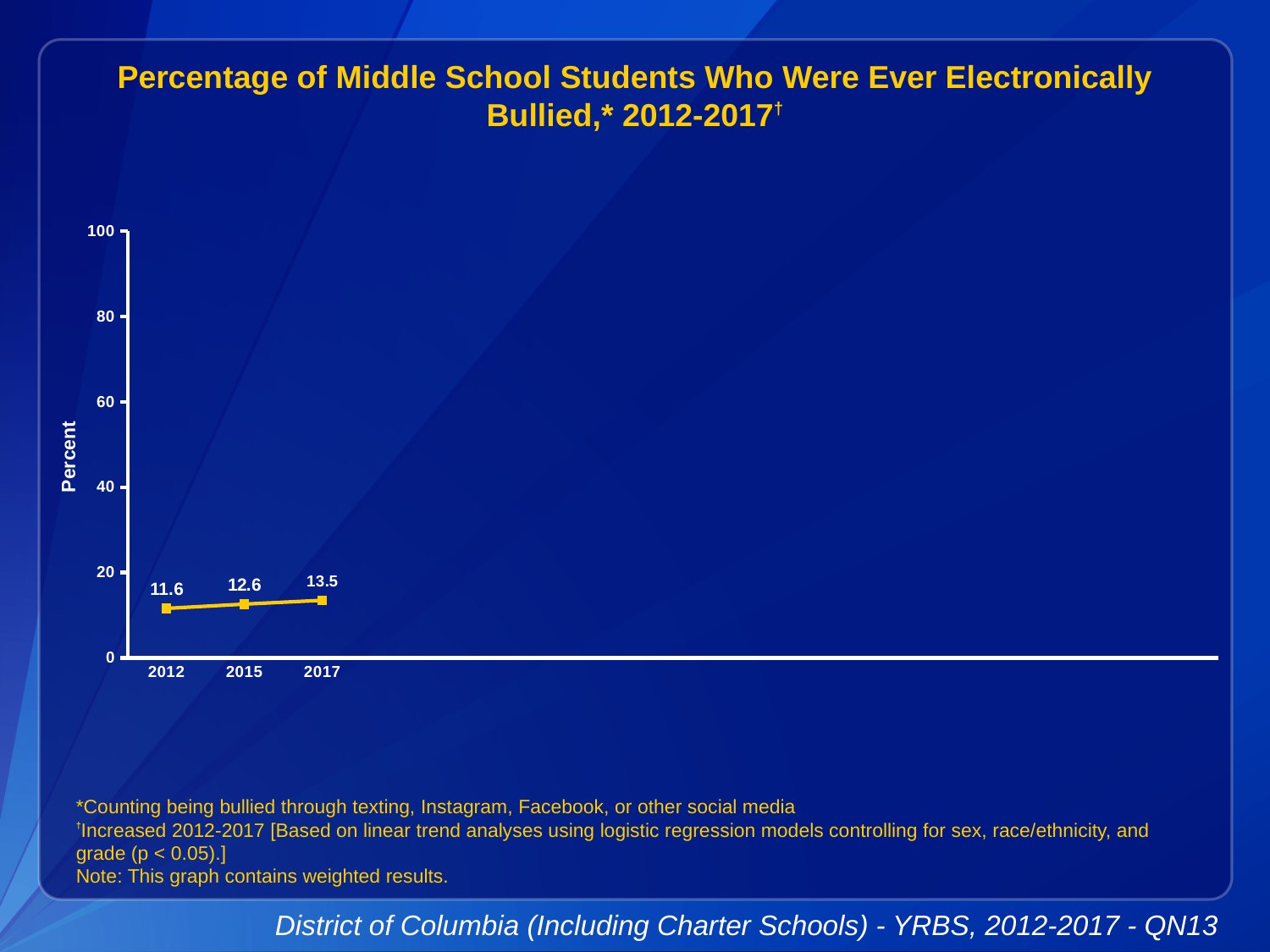
Which is larger, the value for 2015 or the value for 2017? 2017 What kind of chart is shown? line chart How many years are plotted on the chart? 3 What is the value for 2017? 13.5 Do the values rise or fall from 2012 to 2017? rise What is the difference between the values for 2017 and 2012? 1.9 What is the value for 2015? 12.6 Which year has the lowest value? 2012 What is the difference between the values for 2015 and 2012? 1.0 What is the value for 2012? 11.6 Which year has the highest value? 2017 Is the value for 2017 greater or less than 20? less